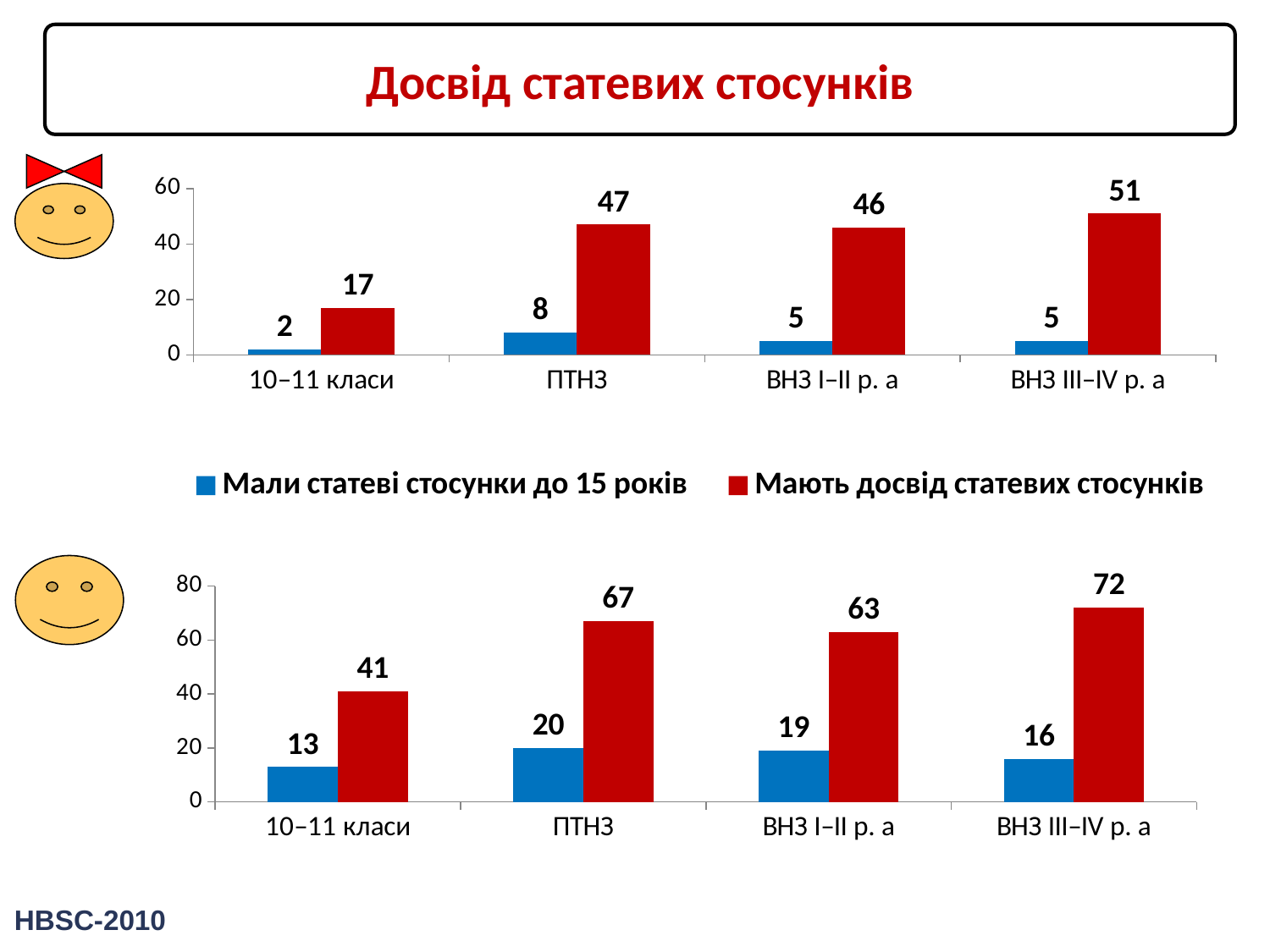
In the top chart, which category has the highest value for 'Мають досвід статевих стосунків'? ВНЗ III–IV р. а In the bottom chart, which category has the lowest value for 'Мали статеві стосунки до 15 років'? 10–11 класи In the top chart, what is the difference between the two series values for 10–11 класи? 15 In the bottom chart, what is the value for 'Мали статеві стосунки до 15 років' for ВНЗ I–II р. а? 19 What colour represents 'Мають досвід статевих стосунків' in the legend? red What type of chart is the bottom chart? bar chart In the bottom chart, what is the difference between the 'Мають досвід статевих стосунків' values for ВНЗ III–IV р. а and 10–11 класи? 31 In the bottom chart, is the 'Мають досвід статевих стосунків' value for ПТНЗ greater or less than 60? greater How many series does the legend list? 2 How many categories are shown on the x axis of the top chart? 4 In the top chart, what is the value for 'Мають досвід статевих стосунків' for ПТНЗ? 47 In the top chart, which is larger: the 'Мали статеві стосунки до 15 років' value for ПТНЗ or for ВНЗ I–II р. а? ПТНЗ